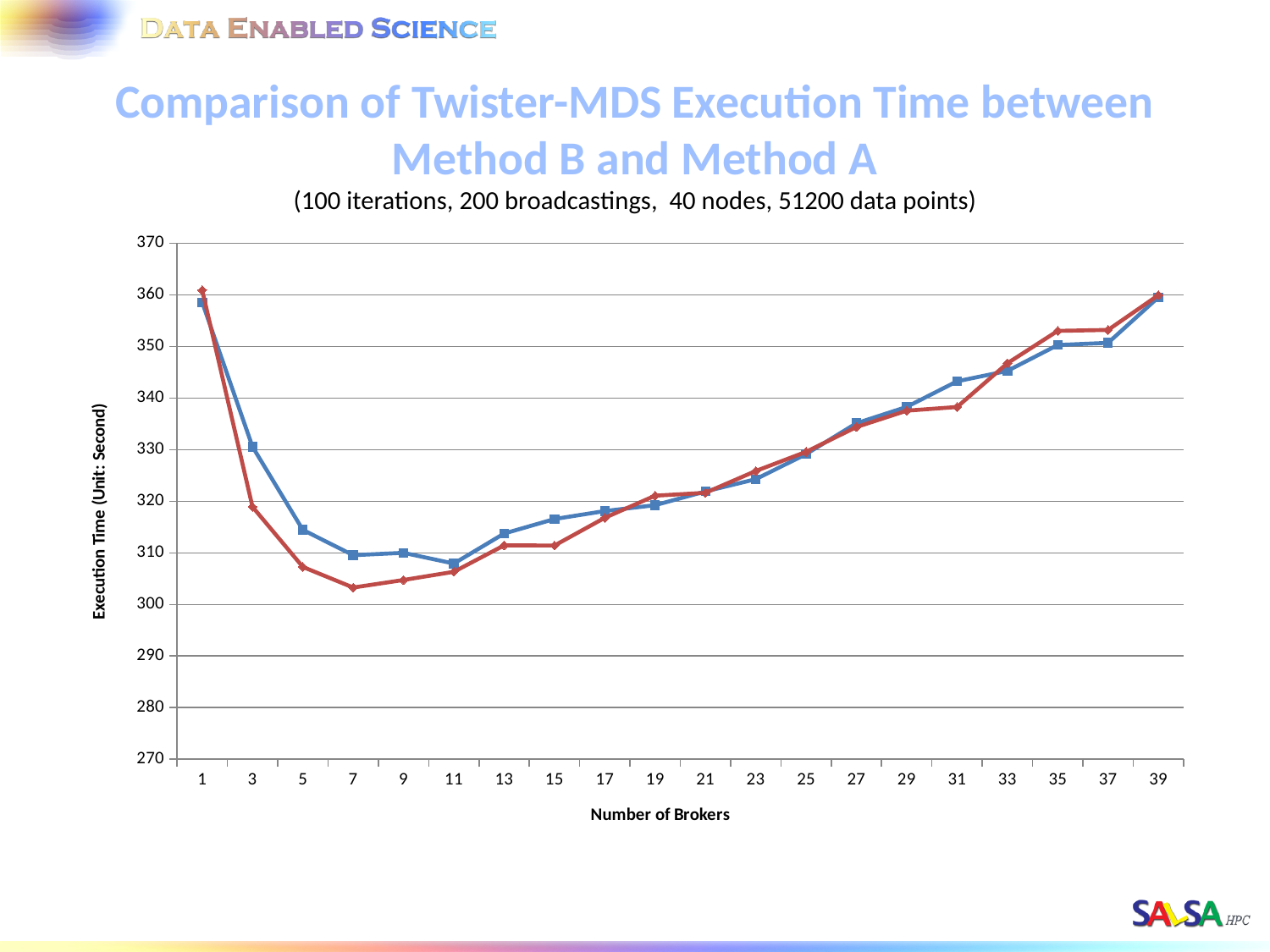
Is the value of the red line at 7 brokers greater or less than 310? less Is the value of the blue line at 31 brokers greater or less than 340? greater What is the title of the y axis? Execution Time (Unit: Second) At 35 brokers, which line has the higher execution time, the blue line or the red line? red line What is the title of the x axis? Number of Brokers How many lines are plotted on the chart? 2 At 3 brokers, which line has the higher execution time, the blue line or the red line? blue line What kind of chart is shown on the slide? line chart How many points along the x axis (Number of Brokers) are labelled on the chart? 20 Is the value of the red line at 11 brokers greater or less than 310? less Do the execution times rise or fall as the number of brokers increases from 1 to 7? fall